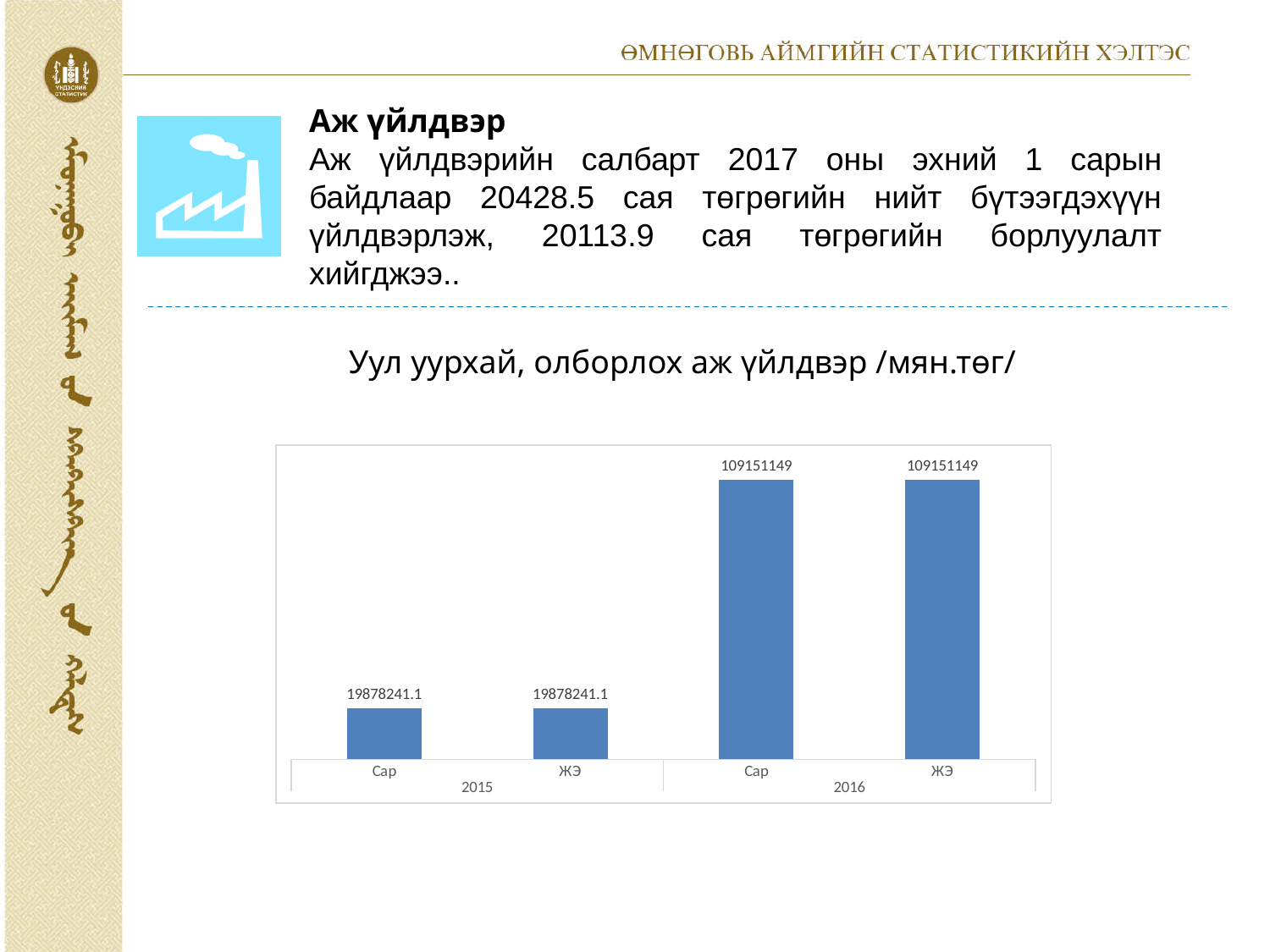
Which year has the higher bars, 2015 or 2016? 2016 Do the values rise or fall from 2015 to 2016? rise What is the value of the ЖЭ bar for 2015? 19878241.1 What is the difference between the Сар value for 2016 and the Сар value for 2015? 89272907.9 What kind of chart is shown on the slide? bar chart What is the title of the chart? Уул уурхай, олборлох аж үйлдвэр /мян.төг/ What is the difference between the ЖЭ value for 2016 and the ЖЭ value for 2015? 89272907.9 What is the value of the ЖЭ bar for 2016? 109151149 How many bars are plotted in the chart? 4 Is the Сар value for 2016 larger or smaller than the Сар value for 2015? larger What is the value of the Сар bar for 2015? 19878241.1 What is the value of the Сар bar for 2016? 109151149